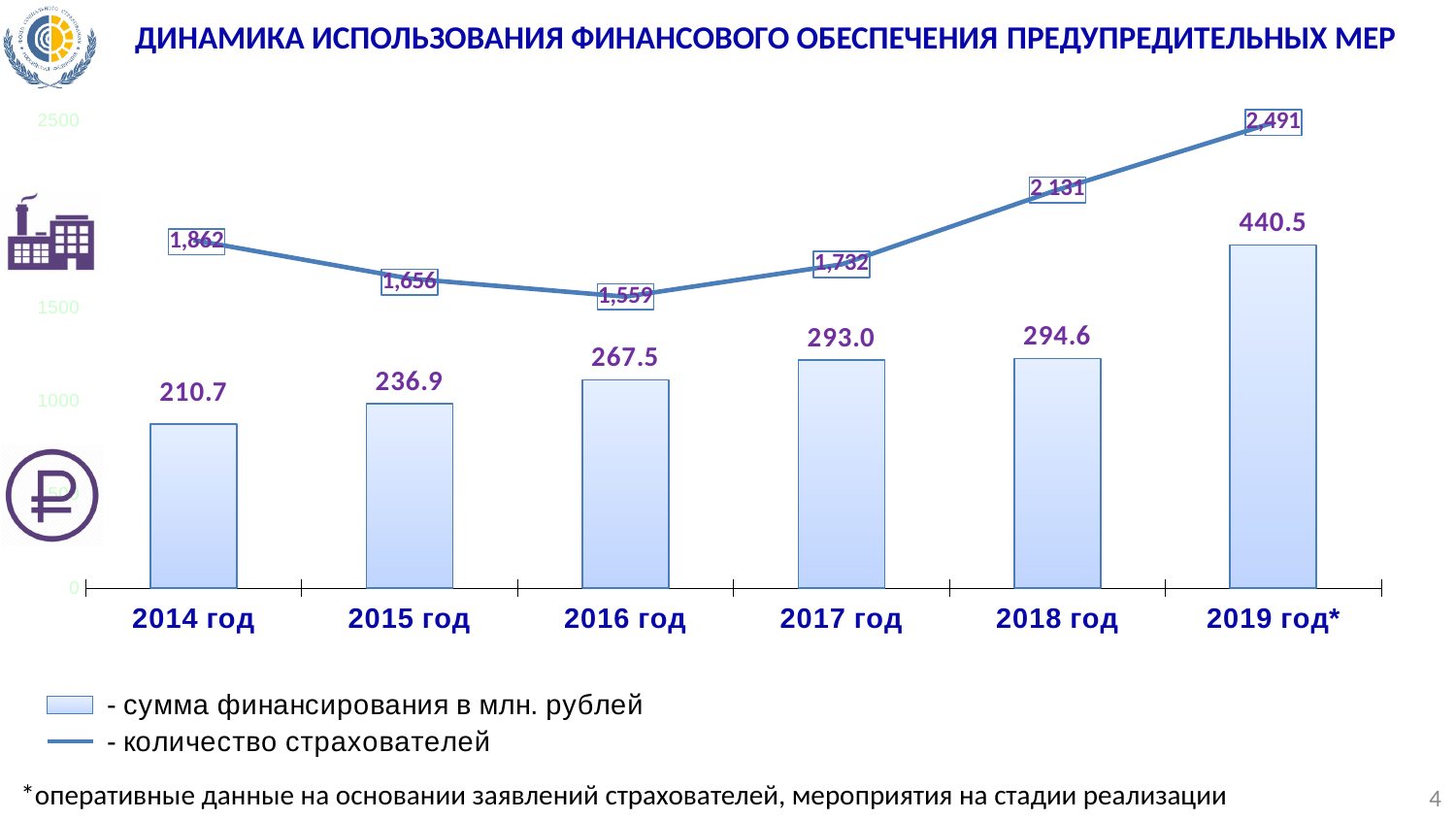
How many years are shown on the x axis? 6 Which year has the lowest количество страхователей? 2016 год Which year has the larger количество страхователей, 2014 год or 2017 год? 2014 год How many series does the legend list? 2 What unit does the legend give for the сумма финансирования series? млн. рублей Which year has the highest сумма финансирования? 2019 год* What kind of chart is shown on the slide? Combined bar and line chart What is the difference in количество страхователей between 2019 год* and 2014 год? 629 Does the сумма финансирования rise or fall from 2014 год to 2019 год*? Rise What is the difference in сумма финансирования between 2019 год* and 2018 год? 145.9 What is the сумма финансирования value for 2016 год? 267.5 What is the количество страхователей value for 2018 год? 2,131